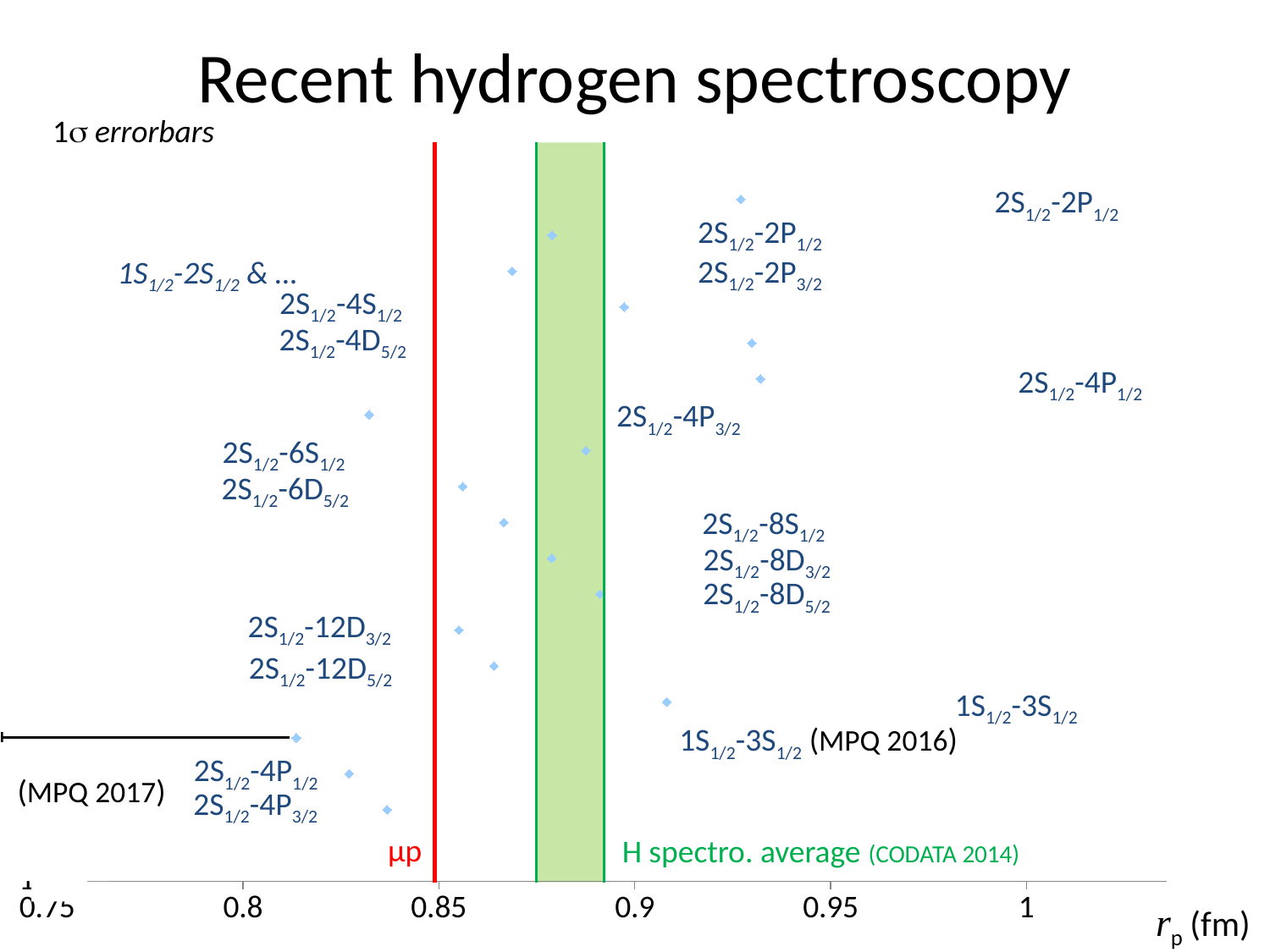
Which is larger: the 1S1/2-3S1/2 (MPQ 2016) value or the 2S1/2-4P (MPQ 2017) values? 1S1/2-3S1/2 (MPQ 2016) Is the μp value (red line) greater or less than 0.9? less What does the red vertical line represent? μp Which is larger: the μp value or the H spectro. average (CODATA 2014)? H spectro. average (CODATA 2014) Is the H spectro. average (CODATA 2014) band greater or less than 0.9? less Is the H spectro. average (CODATA 2014) band greater or less than 0.85? greater What kind of chart is shown on the slide? scatter chart What quantity is plotted on the x axis? r_p (fm)